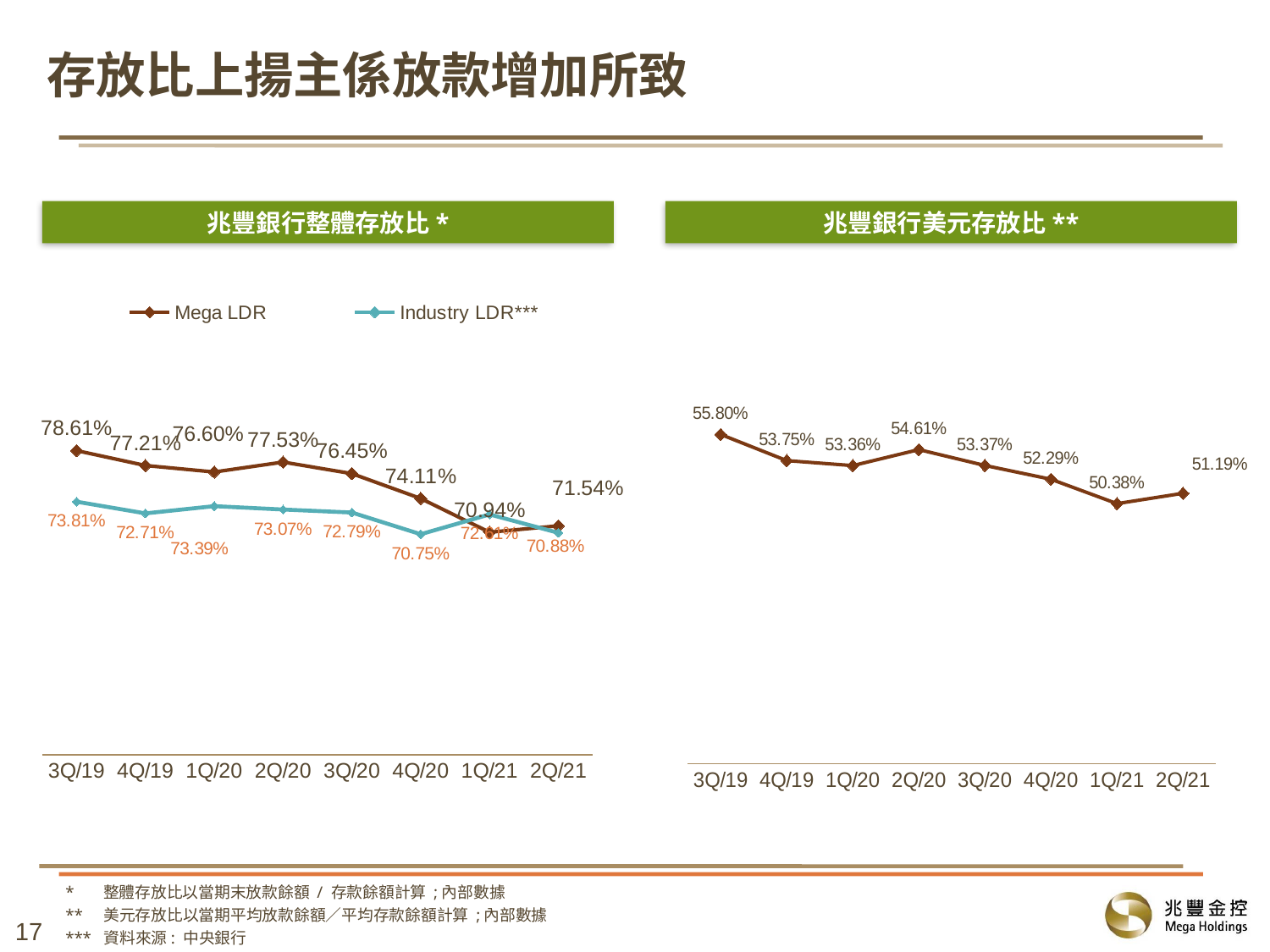
In the left chart (兆豐銀行整體存放比), which is larger at 3Q/20, the Mega LDR or the Industry LDR? Mega LDR In the left chart (兆豐銀行整體存放比), what is the Industry LDR value for 4Q/20? 70.75% In the left chart (兆豐銀行整體存放比), what is the Mega LDR value for 3Q/19? 78.61% In the left chart (兆豐銀行整體存放比), by how many percentage points did the Mega LDR fall from 3Q/19 to 2Q/21? 7.07 percentage points In the right chart (兆豐銀行美元存放比), what is the value for 2Q/20? 54.61% How many series does the legend of the left chart (兆豐銀行整體存放比) list? 2 In the left chart (兆豐銀行整體存放比), in which quarter is the Mega LDR highest? 3Q/19 In the right chart (兆豐銀行美元存放比), what is the difference between the 3Q/19 value and the 2Q/21 value? 4.61 percentage points What kind of chart is the left chart (兆豐銀行整體存放比)? Line chart How many quarters are plotted in the right chart (兆豐銀行美元存放比)? 8 In the right chart (兆豐銀行美元存放比), in which quarter is the value lowest? 1Q/21 In the left chart (兆豐銀行整體存放比), in which quarter is the Mega LDR lowest? 1Q/21